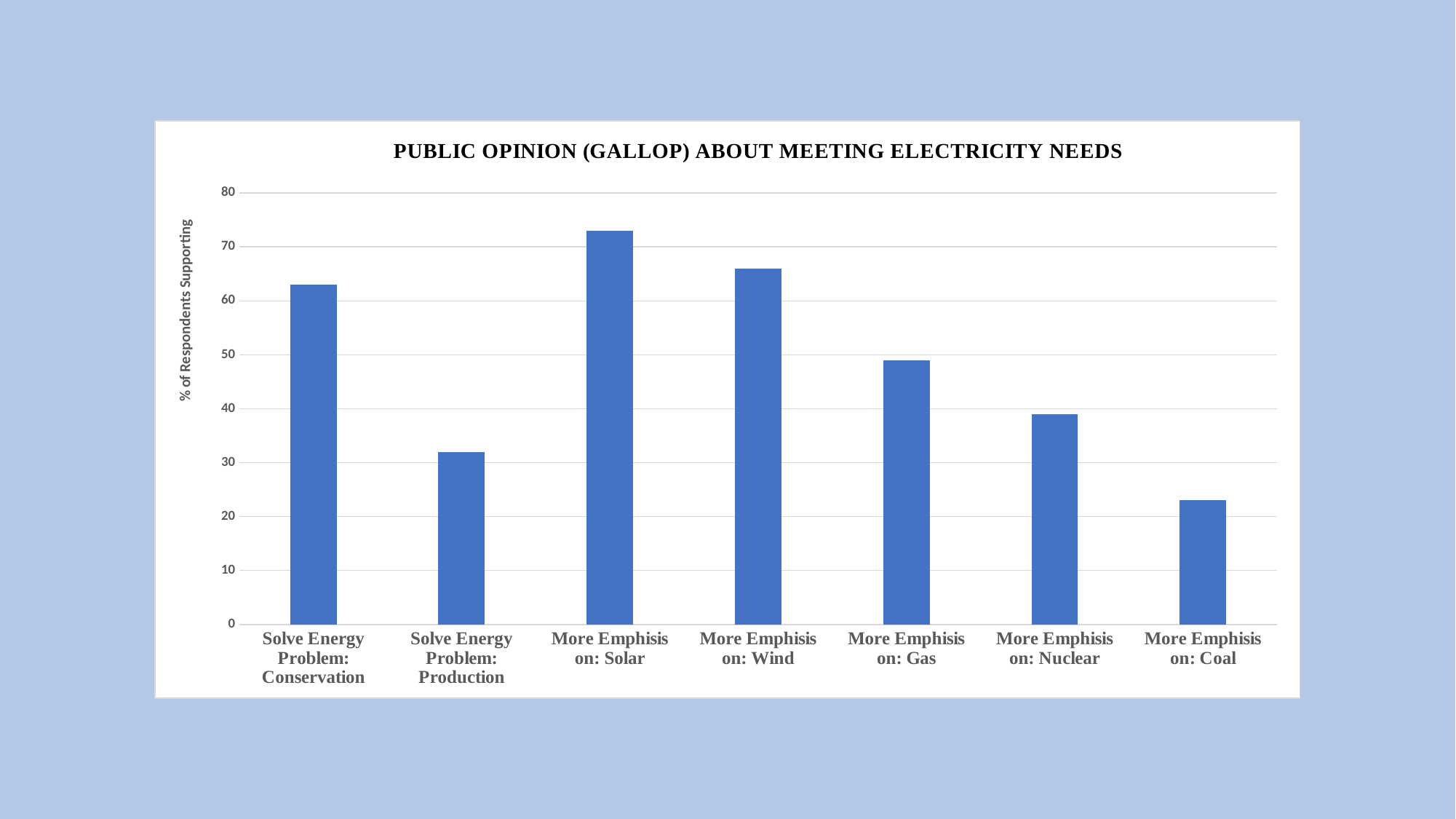
Which is larger, the value for Solve Energy Problem: Conservation or Solve Energy Problem: Production? Solve Energy Problem: Conservation What type of chart is shown on the slide? bar chart Which category has the lowest value? More Emphisis on: Coal Is the value for More Emphisis on: Wind greater or less than 70? less What is the title of the chart? PUBLIC OPINION (GALLOP) ABOUT MEETING ELECTRICITY NEEDS Which is larger, the value for More Emphisis on: Nuclear or More Emphisis on: Gas? More Emphisis on: Gas How many categories are plotted in the chart? 7 Is the value for More Emphisis on: Gas greater or less than 40? greater Is the value for More Emphisis on: Coal greater or less than 30? less Which category has the highest value? More Emphisis on: Solar